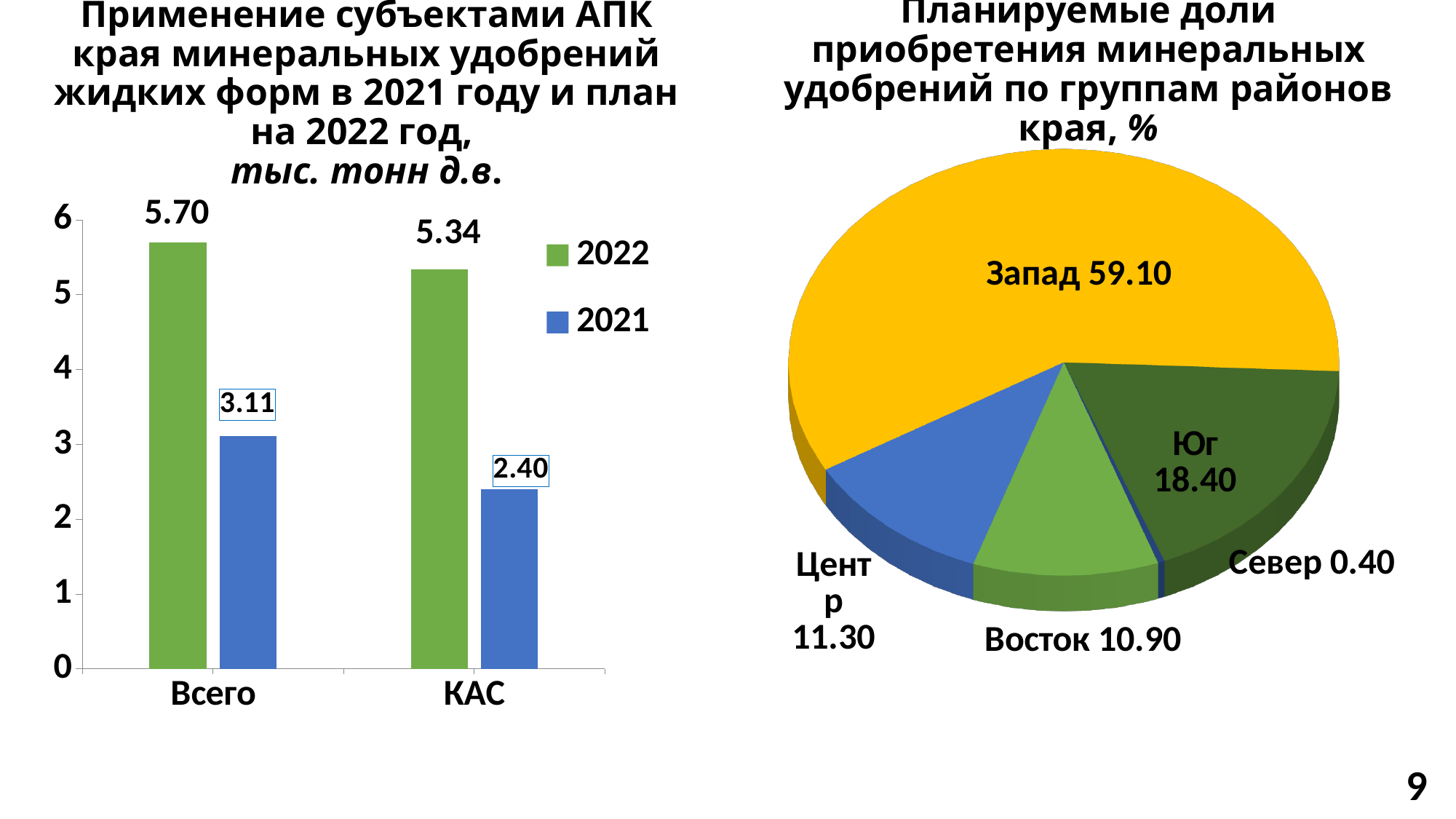
In the left bar chart, what is the value for Всего in the 2022 series? 5.70 In the left bar chart, how many categories are shown on the x axis? 2 In the right pie chart, what is the difference between the shares of Юг and Восток? 7.50 In the right pie chart, which group has the largest share? Запад What kind of chart is the left chart? bar chart In the right pie chart, what is the share for Запад? 59.10 In the left bar chart, how many series does the legend list? 2 In the right pie chart, which group has the smallest share? Север In the right pie chart, how many slices are there? 5 In the left bar chart, what is the difference between the 2022 and 2021 values for Всего? 2.59 In the left bar chart, what is the value for КАС in the 2021 series? 2.40 In the left bar chart, which is larger for КАС: the 2022 value or the 2021 value? 2022